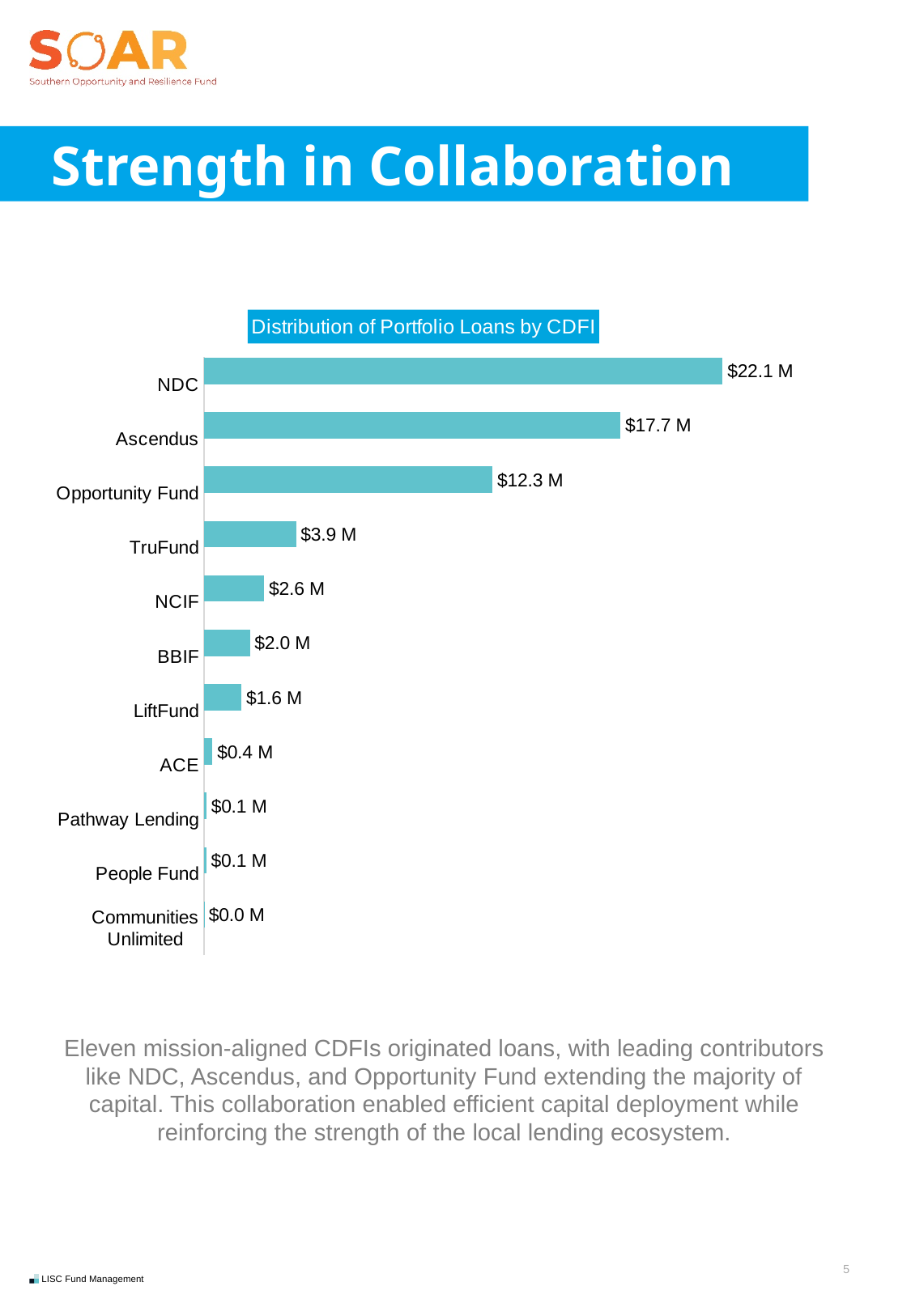
What is the value for Opportunity Fund? $12.3 M How many CDFIs are shown in the chart? 11 Which is larger, the value for BBIF or the value for LiftFund? BBIF What is the title of the chart? Distribution of Portfolio Loans by CDFI What is the value for LiftFund? $1.6 M What is the value for ACE? $0.4 M What is the difference between the values for NDC and Ascendus? $4.4 M What is the value for NDC? $22.1 M Which CDFI has the lowest value? Communities Unlimited Which CDFI has the highest value? NDC What kind of chart is shown on the slide? Bar chart What is the difference between the values for TruFund and NCIF? $1.3 M